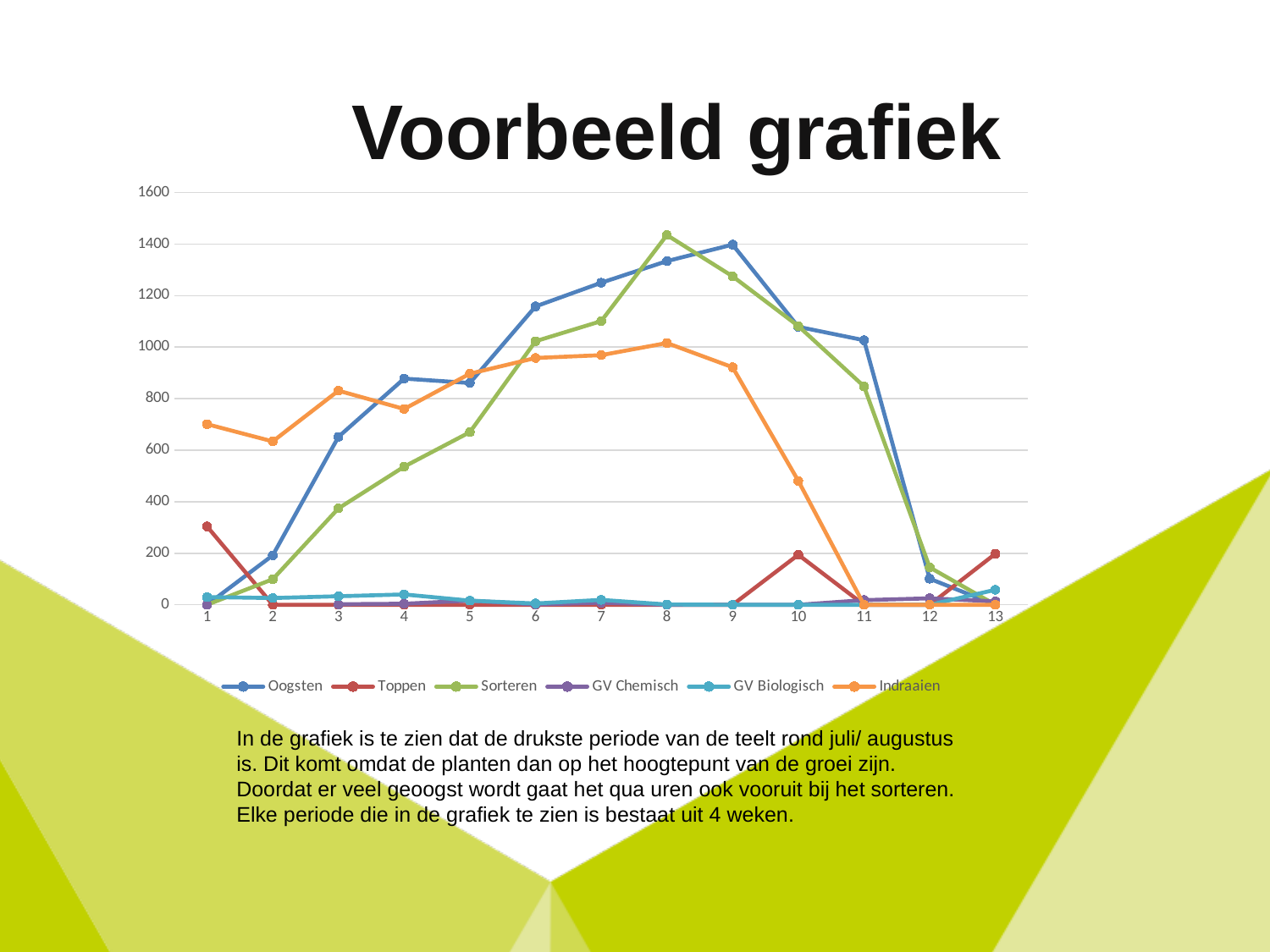
Which series is shown in orange in the legend? Indraaien Is the value for Toppen at point 1 greater or less than 200? greater What kind of chart is shown on the slide? Line chart At which x-axis point does the Sorteren series reach its highest value? 8 How many points are plotted along the x axis? 13 Is the value for Oogsten at point 8 greater or less than 1200? greater Does the Oogsten series rise or fall from point 1 to point 9? Rise How many series does the legend list? 6 Is the value for Indraaien at point 10 greater or less than 600? less At point 5, which is larger: Indraaien or Sorteren? Indraaien What is the title of the slide containing the chart? Voorbeeld grafiek At which x-axis point does the Oogsten series reach its highest value? 9